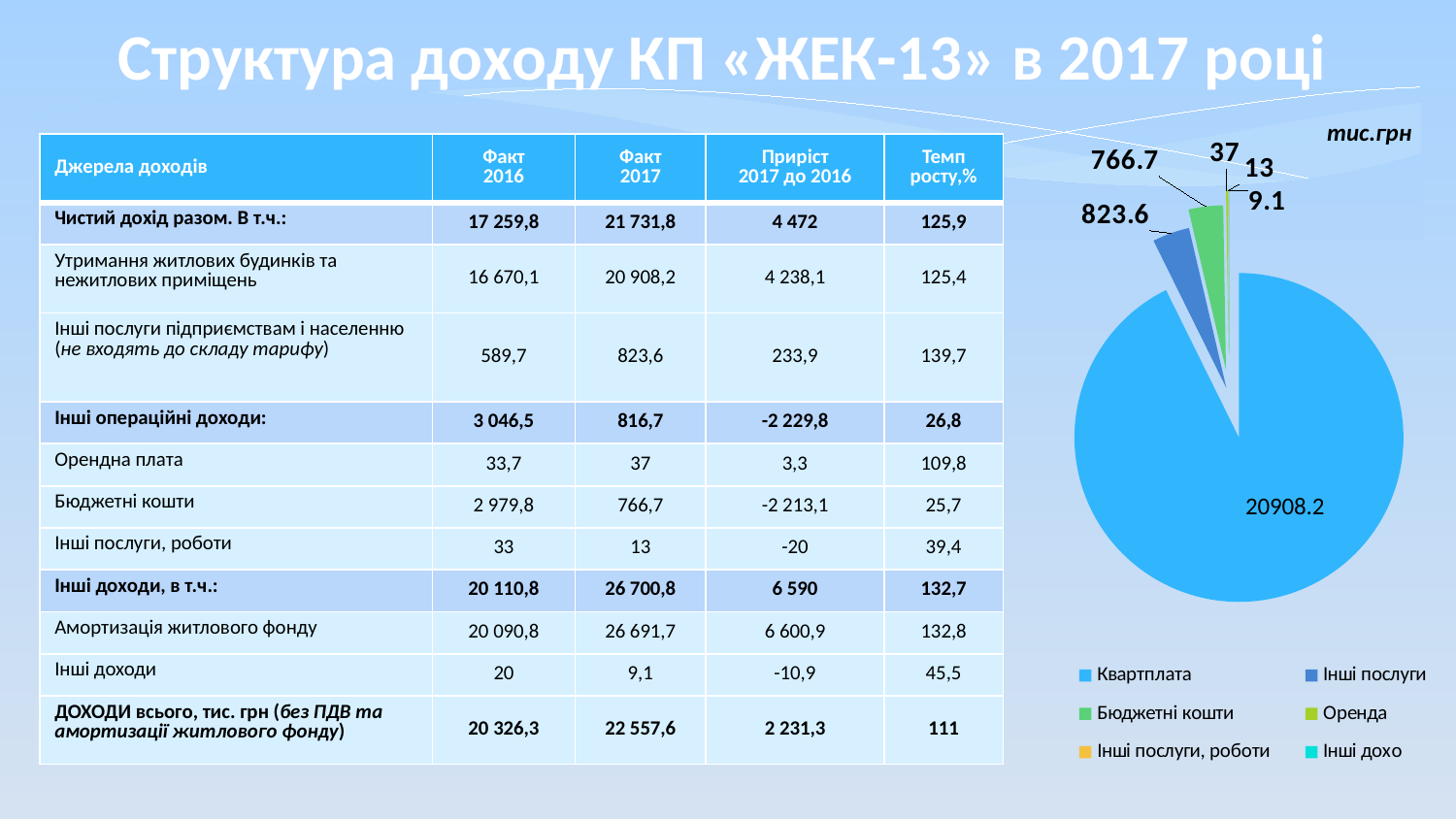
What unit is indicated above the pie chart? тис.грн How many entries does the pie chart's legend list? 6 In the pie chart, what is the value of the Бюджетні кошти slice? 766.7 In the pie chart, what is the value of the Оренда slice? 37 Which category has the largest slice in the pie chart? Квартплата How many slices does the pie chart have? 6 In the pie chart, which is larger: the Оренда slice or the Інші послуги, роботи slice? Оренда In the pie chart, what is the difference between the Інші послуги slice and the Бюджетні кошти slice? 56.9 Which slice in the pie chart has the smallest value? Інші дохо What kind of chart is shown on the right side of the slide? pie chart In the pie chart, what is the value of the Квартплата slice? 20908.2 In the pie chart, what is the value of the Інші послуги slice? 823.6